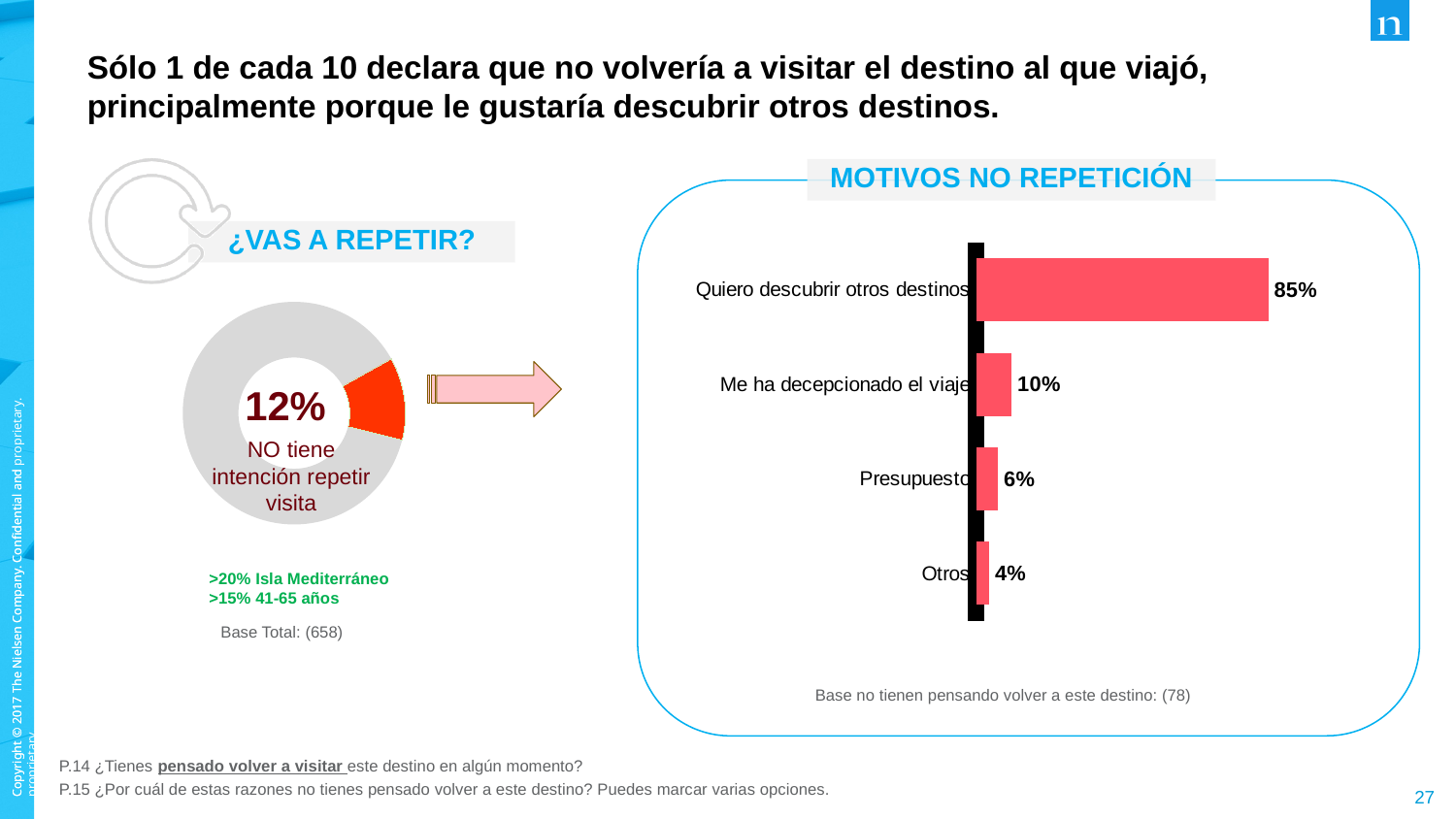
In the MOTIVOS NO REPETICIÓN chart, which category has the highest value? Quiero descubrir otros destinos In the MOTIVOS NO REPETICIÓN chart, what is the difference between "Quiero descubrir otros destinos" and "Me ha decepcionado el viaje"? 75 percentage points What base is stated below the MOTIVOS NO REPETICIÓN chart? 78 In the MOTIVOS NO REPETICIÓN chart, what is the value for "Quiero descubrir otros destinos"? 85% In the MOTIVOS NO REPETICIÓN chart, which is larger: "Presupuesto" or "Otros"? Presupuesto In the MOTIVOS NO REPETICIÓN chart, what is the value for "Presupuesto"? 6% In the ¿VAS A REPETIR? donut chart on the left, what percentage has no intention of repeating the visit? 12% What kind of chart is the MOTIVOS NO REPETICIÓN chart? Bar chart How many categories are shown in the MOTIVOS NO REPETICIÓN chart? 4 In the MOTIVOS NO REPETICIÓN chart, what is the value for "Otros"? 4% In the MOTIVOS NO REPETICIÓN chart, which category has the lowest value? Otros In the MOTIVOS NO REPETICIÓN chart, what is the value for "Me ha decepcionado el viaje"? 10%